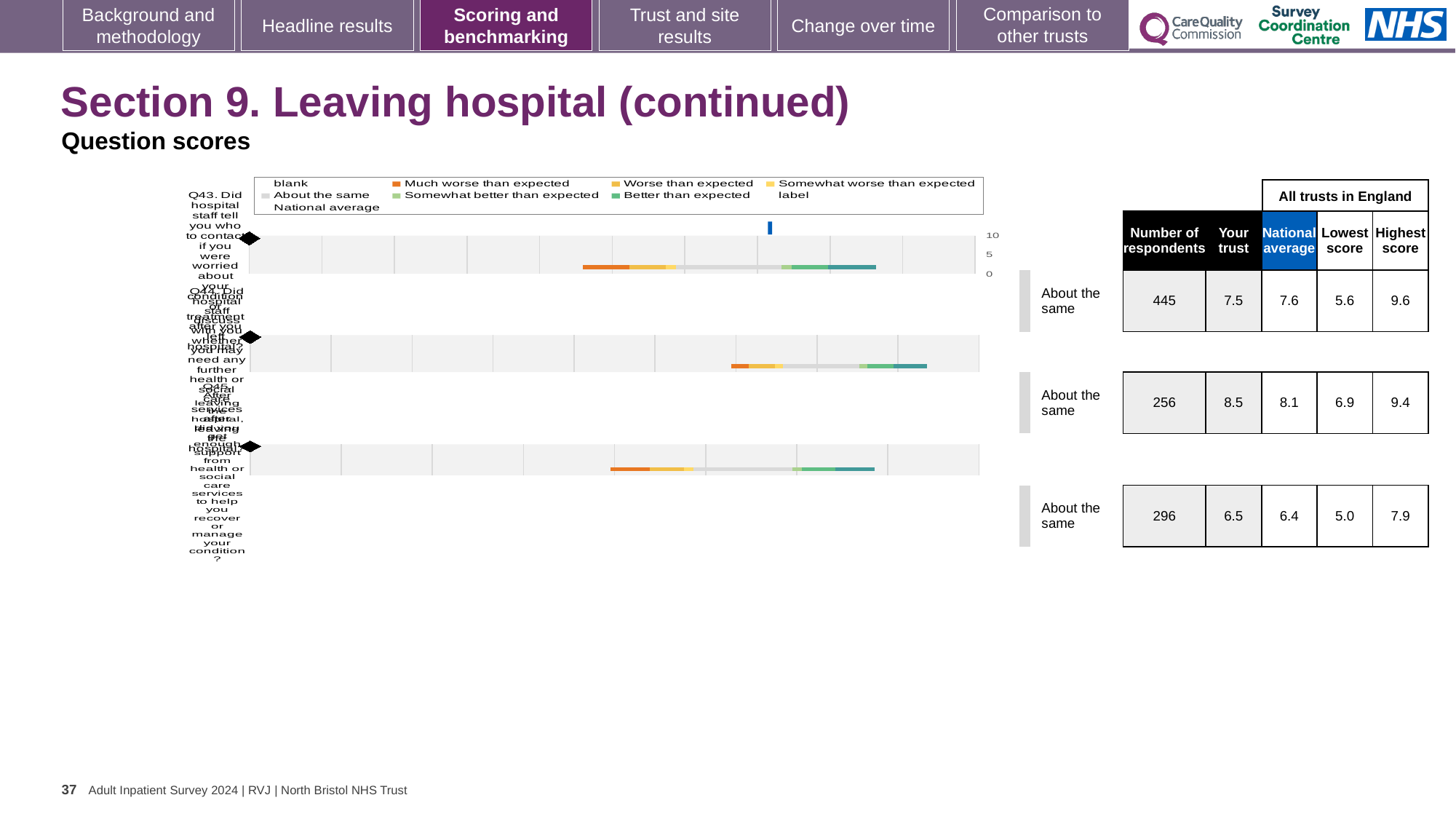
For the first (top) question row, how many respondents are listed in the table? 445 For the first (top) question row, which is larger: the 'Your trust' score or the national average? National average (7.6) What benchmark category label is shown beside each of the three question rows? About the same Which question row has the highest 'Your trust' score? the second row (8.5) How many question rows (bars) are plotted on the slide? 3 What kind of chart is used for the question scores on this slide? bar chart Which question row has the lowest national average score? the third row (6.4) For the first (top) question row, what is the difference between the highest score and the lowest score across all trusts in England? 4.0 What is the highest tick value shown on the score axis of the charts? 10 How many entries does the legend above the question score charts list? 9 For the third question row, what is the lowest score among all trusts in England? 5.0 For the second question row, what is the 'Your trust' score? 8.5